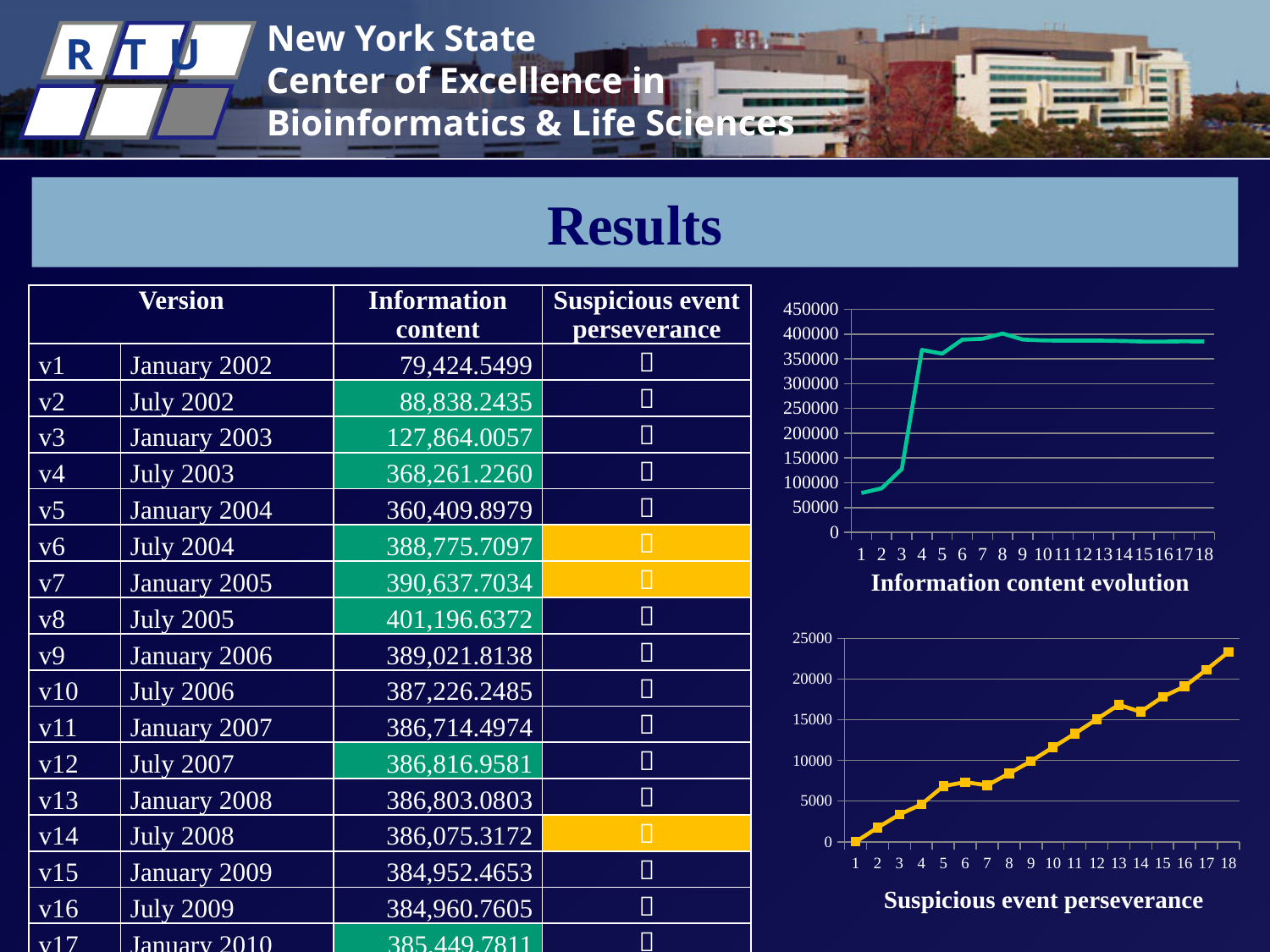
In the 'Information content evolution' chart, which point has the highest value? 8 In the 'Information content evolution' chart, is the value at point 4 greater or less than 350000? greater In the 'Information content evolution' chart, how many points are plotted along the x axis? 18 In the 'Suspicious event perseverance' chart, do the values generally rise or fall from point 1 to point 18? rise In the 'Suspicious event perseverance' chart, is the value at point 18 greater or less than 20000? greater What colour is the line in the 'Suspicious event perseverance' chart? yellow In the 'Information content evolution' chart, is the value at point 1 greater or less than 100000? less What type of chart is the 'Information content evolution' chart? line chart In the 'Information content evolution' chart, which point has the lowest value? 1 In the 'Suspicious event perseverance' chart, how many points are plotted along the x axis? 18 What type of chart is the 'Suspicious event perseverance' chart? line chart